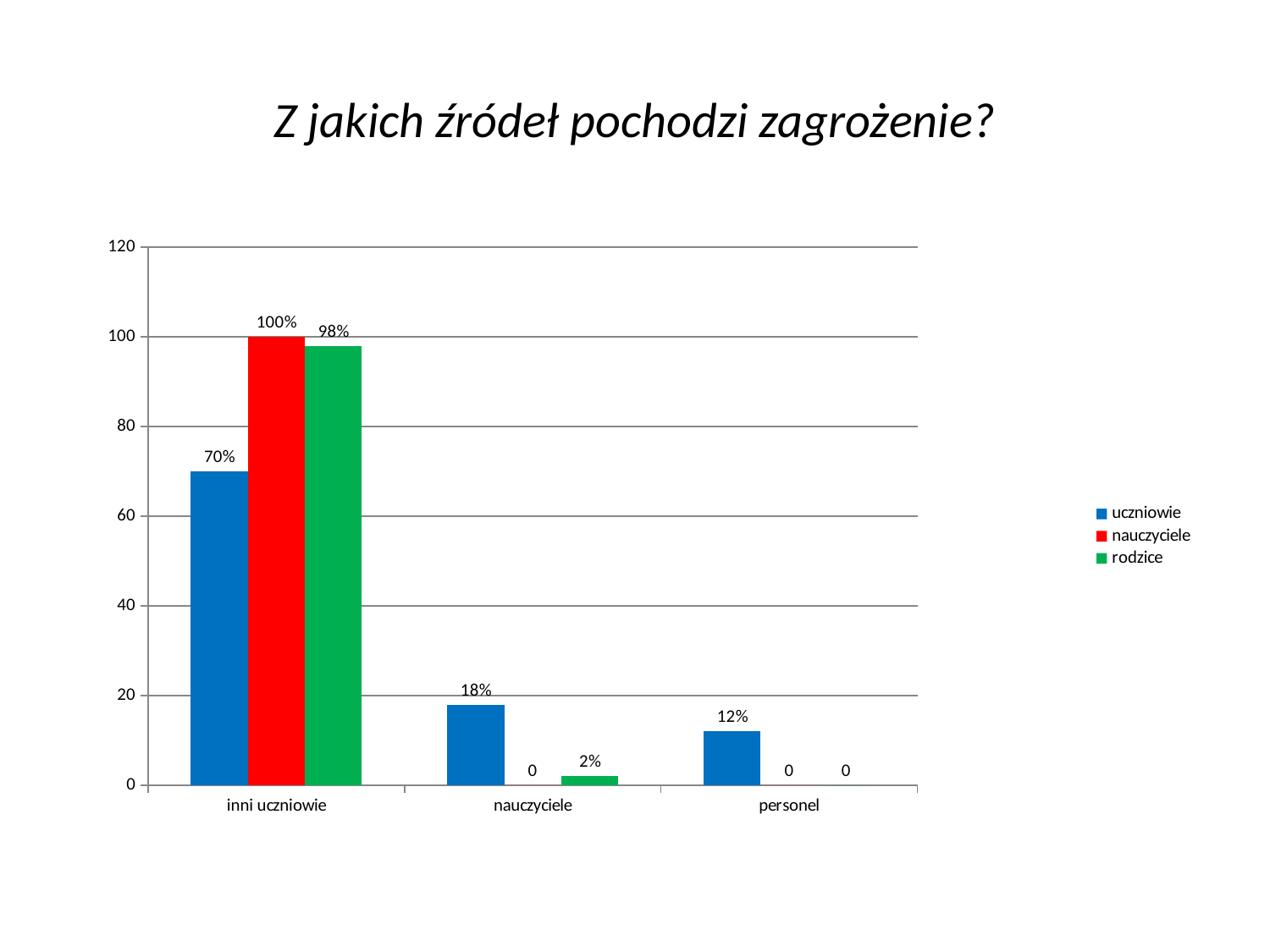
What is the title of the chart? Z jakich źródeł pochodzi zagrożenie? Which is larger in the nauczyciele category: the uczniowie value or the rodzice value? uczniowie How many series does the legend list? 3 How many categories are shown on the x axis? 3 What is the value for rodzice in the nauczyciele category? 2% What kind of chart is shown on the slide? bar chart Which category has the lowest value for the uczniowie series? personel What is the value for uczniowie in the inni uczniowie category? 70% What is the difference between the nauczyciele and rodzice values in the inni uczniowie category? 2% Which category has the highest value for the uczniowie series? inni uczniowie What is the value for uczniowie in the personel category? 12% What is the value for nauczyciele in the inni uczniowie category? 100%